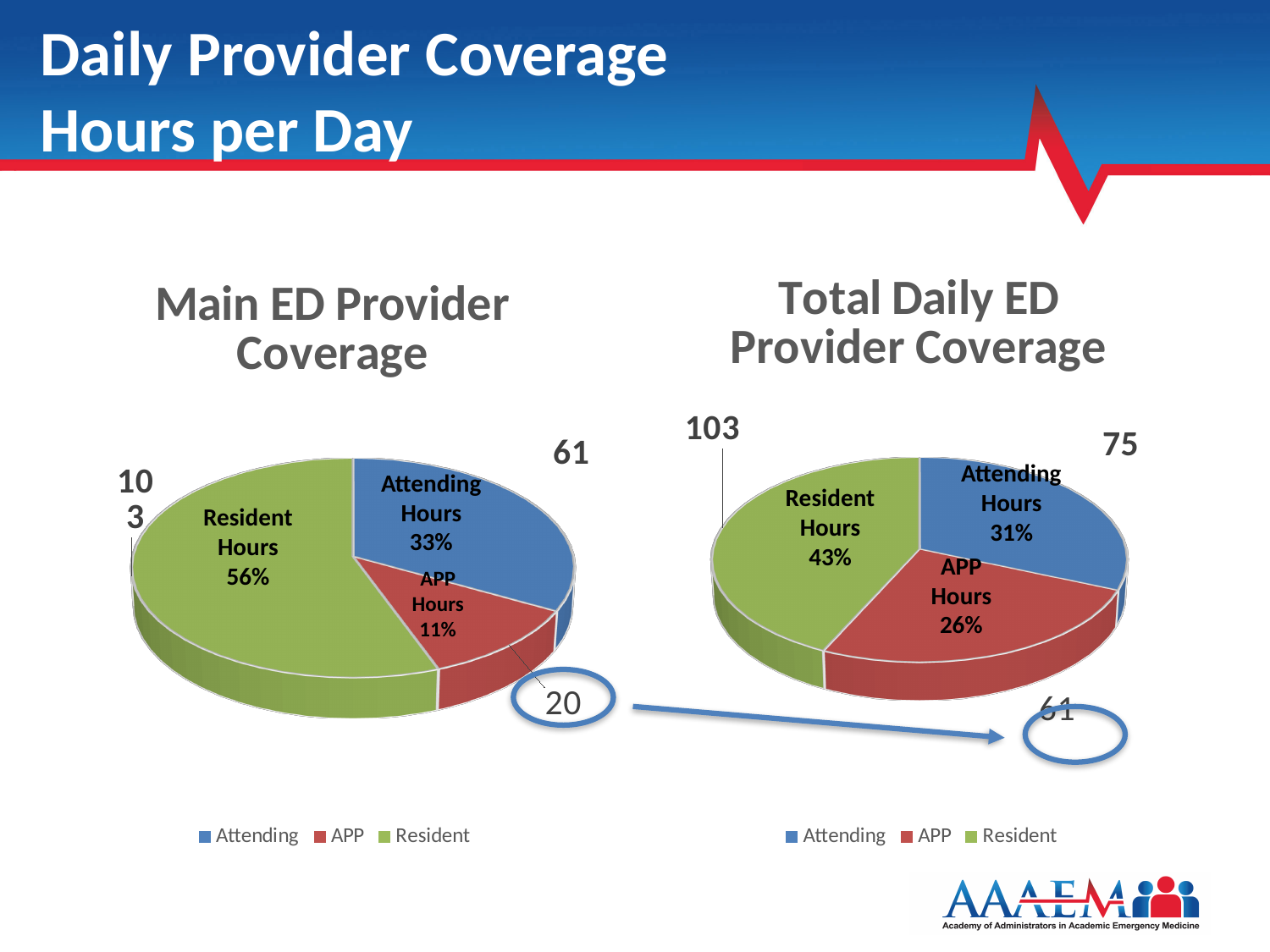
In the Total Daily ED Provider Coverage chart, which slice is the smallest? APP Hours In the Total Daily ED Provider Coverage chart, what is the difference in percentage points between the Resident Hours share and the Attending Hours share? 12 percentage points In the Main ED Provider Coverage chart, what share of the pie is Attending Hours? 33% How many slices does the Total Daily ED Provider Coverage pie chart have? 3 In the Total Daily ED Provider Coverage chart, what share of the pie is Attending Hours? 31% What kind of chart is the Main ED Provider Coverage chart? pie chart In the Total Daily ED Provider Coverage chart, what share of the pie is Resident Hours? 43% In the Main ED Provider Coverage chart, which slice is the largest? Resident Hours How many entries does the legend of the Main ED Provider Coverage chart list? 3